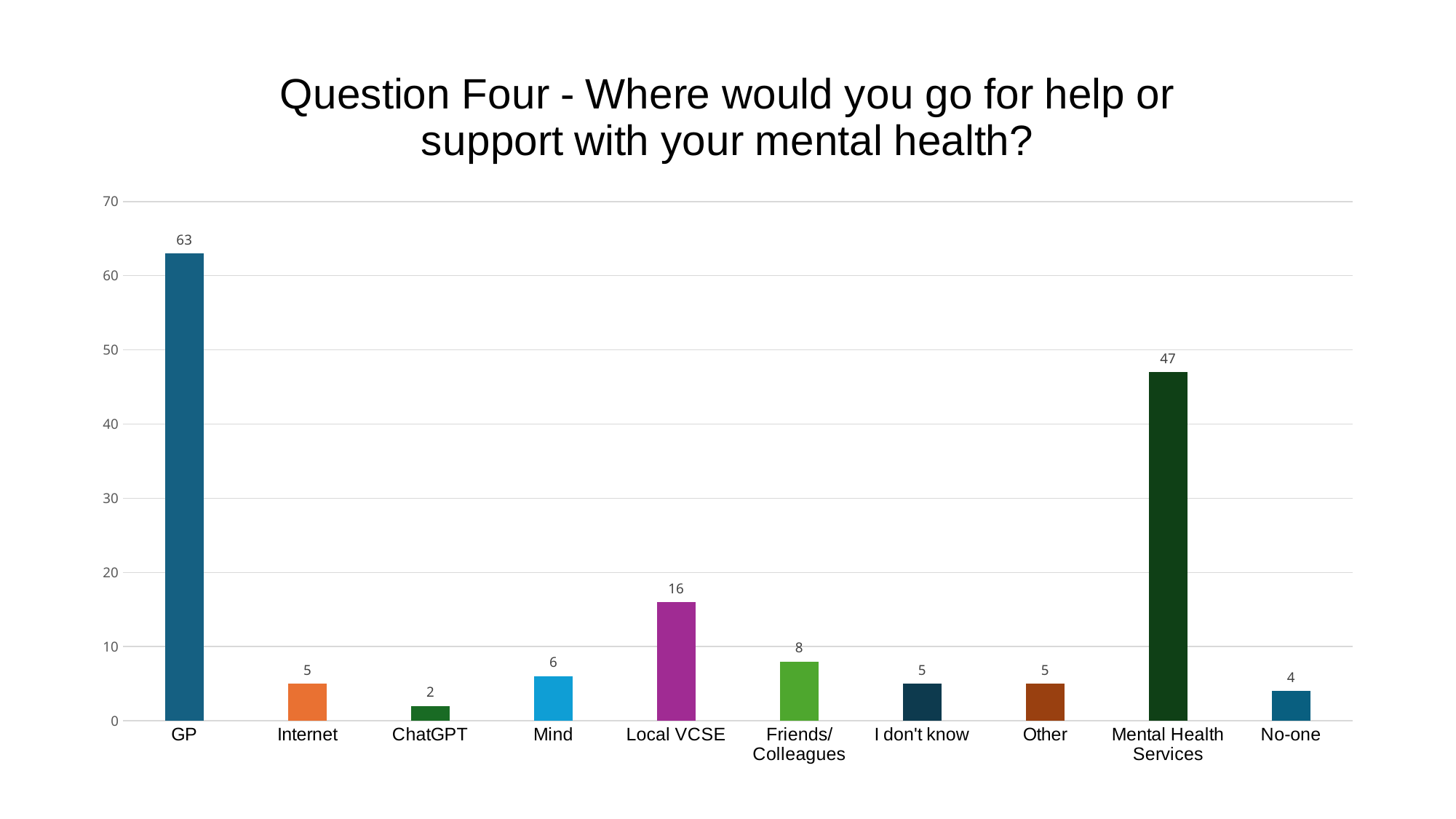
What kind of chart is shown on the slide? Bar chart What is the value for ChatGPT? 2 How many categories are shown on the x axis? 10 What is the value for GP? 63 Is the value for Mental Health Services greater or less than 40? greater What is the value for Mental Health Services? 47 What is the difference between the values for GP and Mental Health Services? 16 Which category has the highest value? GP What is the value for Local VCSE? 16 Which is larger, the value for Local VCSE or the value for Friends/Colleagues? Local VCSE Which category has the lowest value? ChatGPT What is the title of the chart? Question Four - Where would you go for help or support with your mental health?